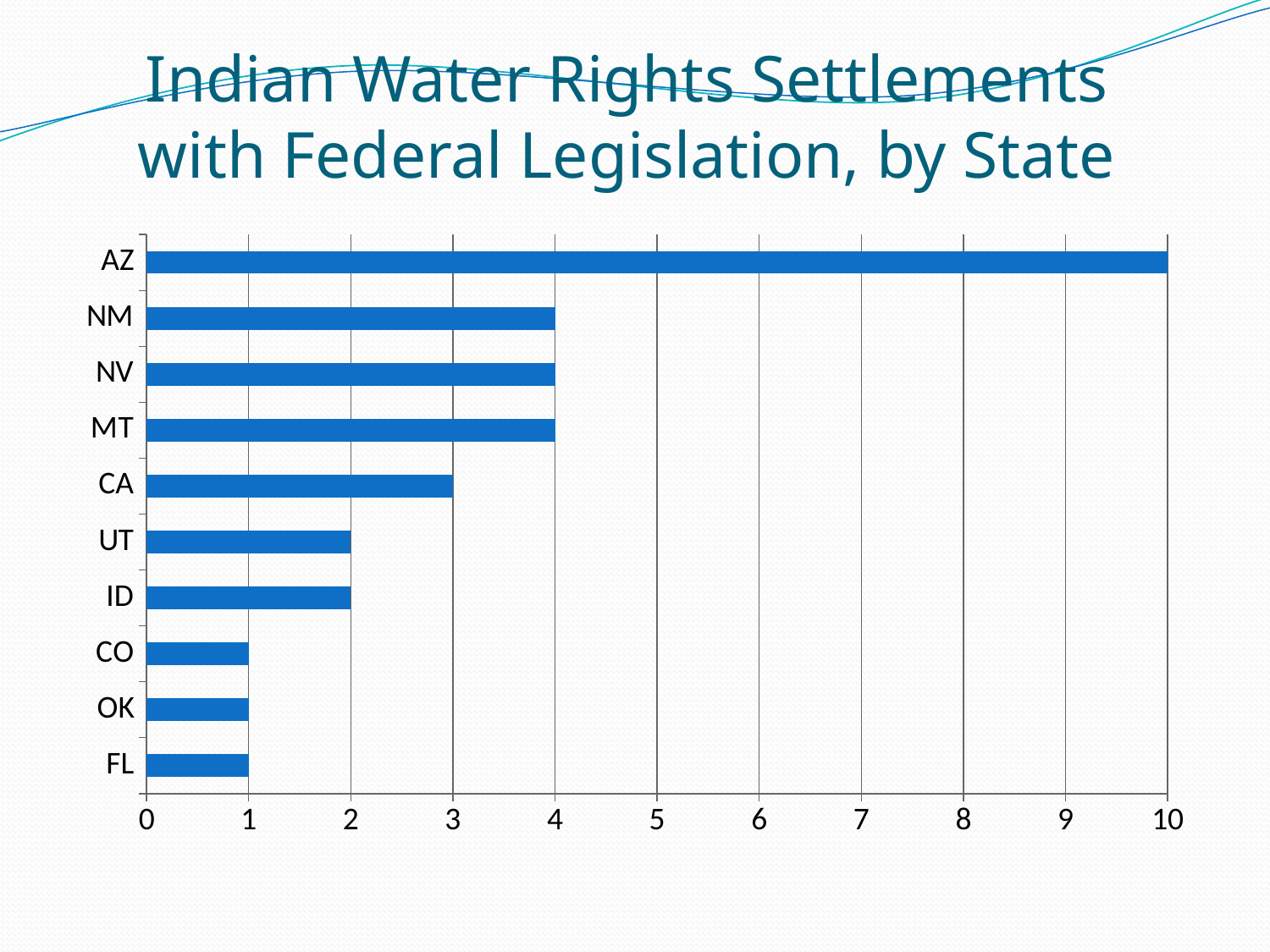
What is the value for CA? 3 What is the value for UT? 2 Which is larger, the value for NV or the value for ID? NV How many states are shown on the chart? 10 What is the value for NM? 4 What is the difference between the values for CA and FL? 2 What is the value for AZ? 10 What kind of chart is shown on the slide? bar chart What is the title of the chart on the slide? Indian Water Rights Settlements with Federal Legislation, by State Which state has the highest value? AZ What is the difference between the values for AZ and MT? 6 Is the value for AZ greater or less than 5? greater